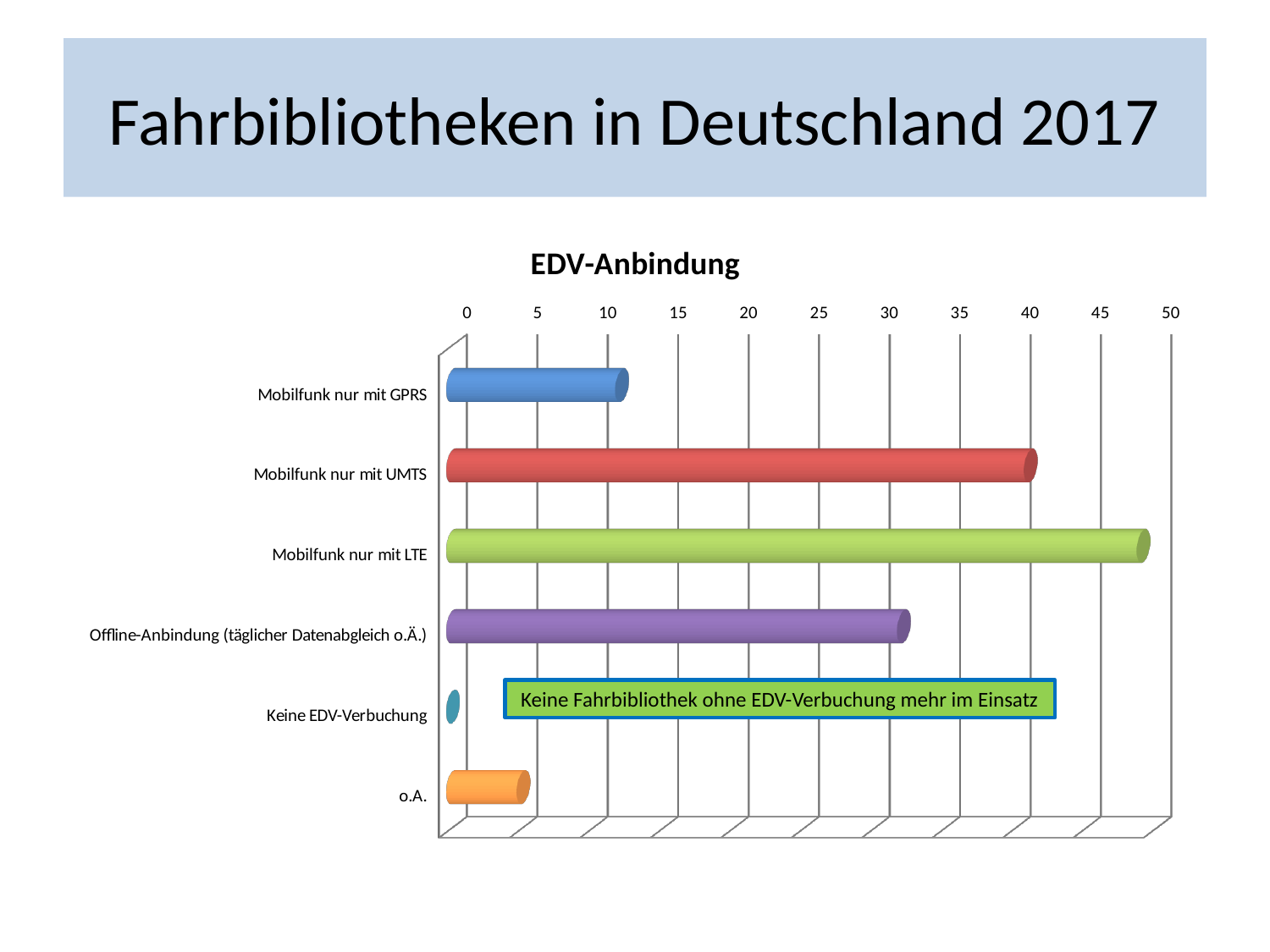
Which is larger, the value for Mobilfunk nur mit UMTS or the value for Mobilfunk nur mit GPRS? Mobilfunk nur mit UMTS What does the text box next to the Keine EDV-Verbuchung bar say? Keine Fahrbibliothek ohne EDV-Verbuchung mehr im Einsatz What type of chart is shown on the slide? Bar chart What is the title of the chart? EDV-Anbindung Is the value for Offline-Anbindung (täglicher Datenabgleich o.Ä.) greater or less than 25? greater Is the value for Mobilfunk nur mit GPRS greater or less than 15? less Which category has the highest value? Mobilfunk nur mit LTE How many categories are shown in the chart? 6 Is the value for Mobilfunk nur mit LTE greater or less than 45? greater Which is larger, the value for Offline-Anbindung (täglicher Datenabgleich o.Ä.) or the value for Mobilfunk nur mit UMTS? Mobilfunk nur mit UMTS Which category has the lowest value? Keine EDV-Verbuchung